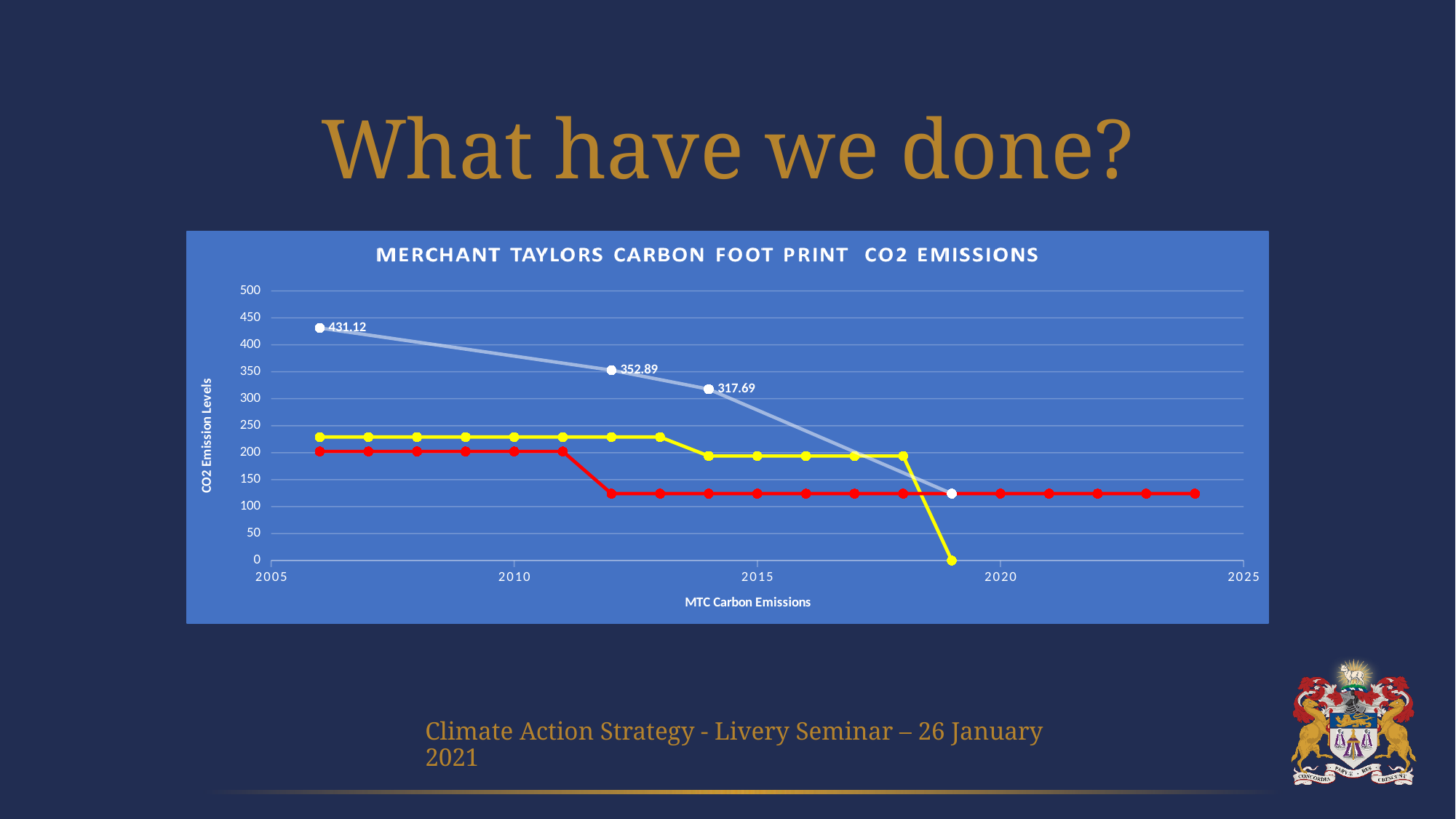
Does the white line rise or fall from 2006 to 2019? fall What is the labelled value of the white line in 2012? 352.89 Is the value of the white line in 2019 greater or less than 150? less Which year has the highest labelled value on the white line? 2006 What is the labelled value of the white line in 2006? 431.12 What is the difference between the white line's labelled values in 2012 and 2014? 35.20 What is the labelled value of the white line in 2014? 317.69 Is the value of the yellow line in 2006 greater or less than 200? greater What type of chart is shown on the slide? line chart What is the label of the vertical axis? CO2 Emission Levels What is the difference between the white line's labelled values in 2006 and 2012? 78.23 What is the title of the chart? MERCHANT TAYLORS CARBON FOOT PRINT CO2 EMISSIONS